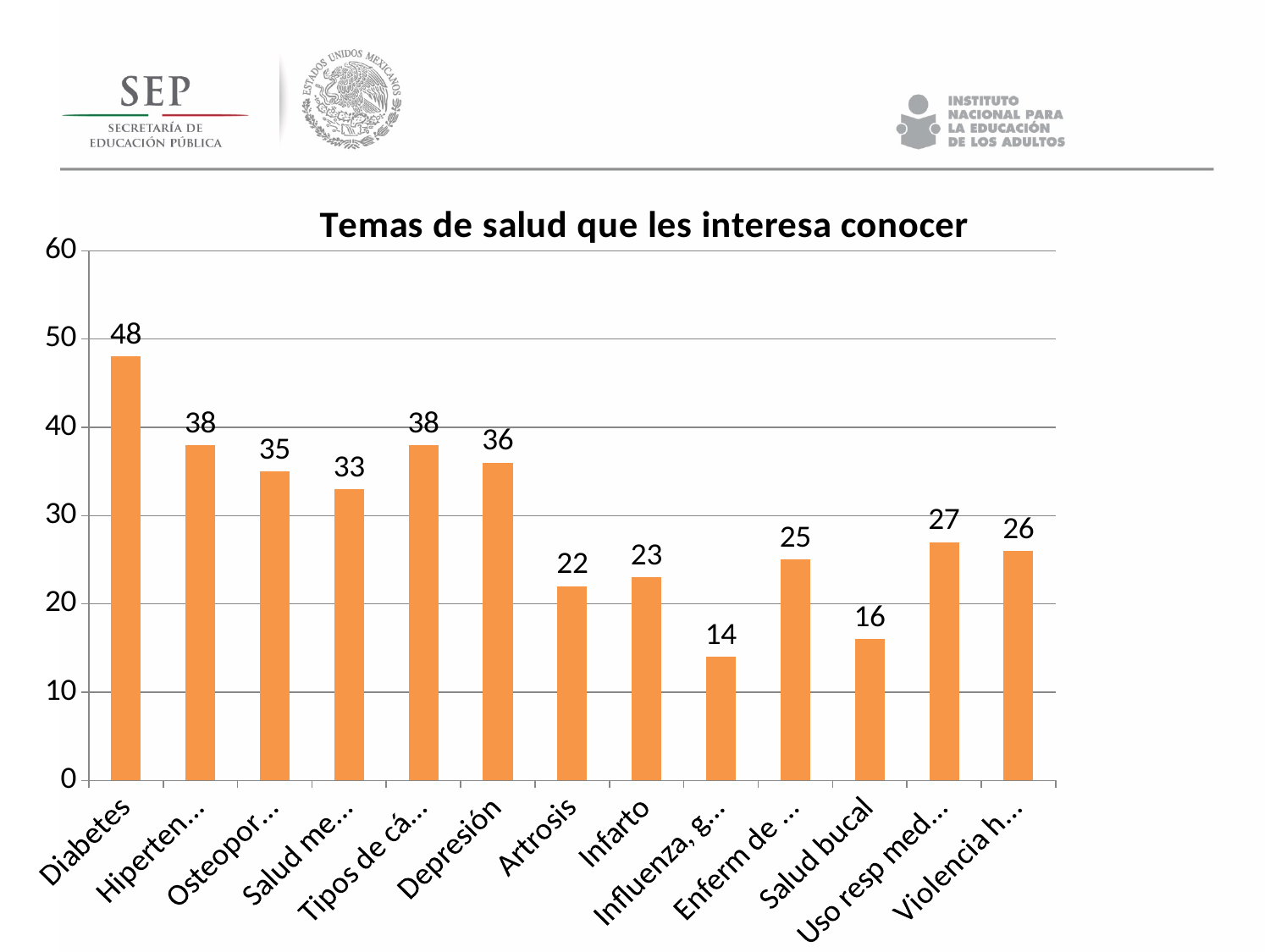
What is the title of the chart? Temas de salud que les interesa conocer What is the value for Depresión? 36 Which category has the lowest value? Influenza What is the value for Salud bucal? 16 What is the difference between the values for Diabetes and Depresión? 12 Which is larger, the value for Infarto or the value for Salud bucal? Infarto What is the value for Artrosis? 22 What kind of chart is shown on the slide? Bar chart How many categories are shown in the chart? 13 What is the value for Diabetes? 48 Which category has the highest value? Diabetes What is the value for Infarto? 23